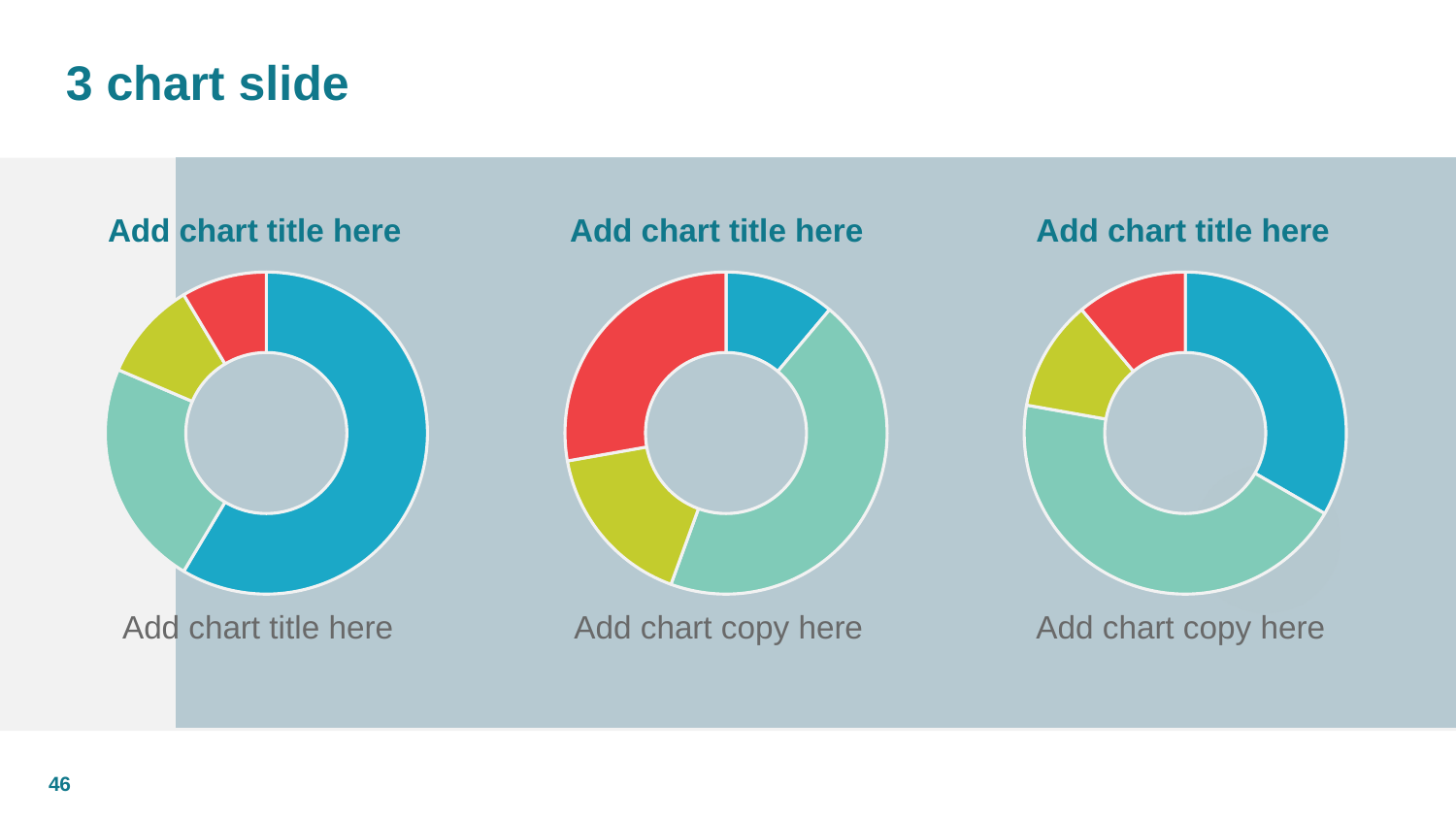
What is the title shown above the left chart? Add chart title here What kind of chart is the middle chart on the slide? Pie chart (donut) In the middle chart, which colour slice is the largest? Light teal In the left chart, is the blue slice larger or smaller than the red slice? Larger In the left chart, which colour slice is the largest? Blue In the middle chart, is the red slice larger or smaller than the blue slice? Larger How many slices does the left chart have? 4 How many slices does the middle chart have? 4 How many slices does the right chart have? 4 How many charts are shown on the slide? 3 In the middle chart, which colour slice is the smallest? Blue What kind of chart is the left chart on the slide? Pie chart (donut)